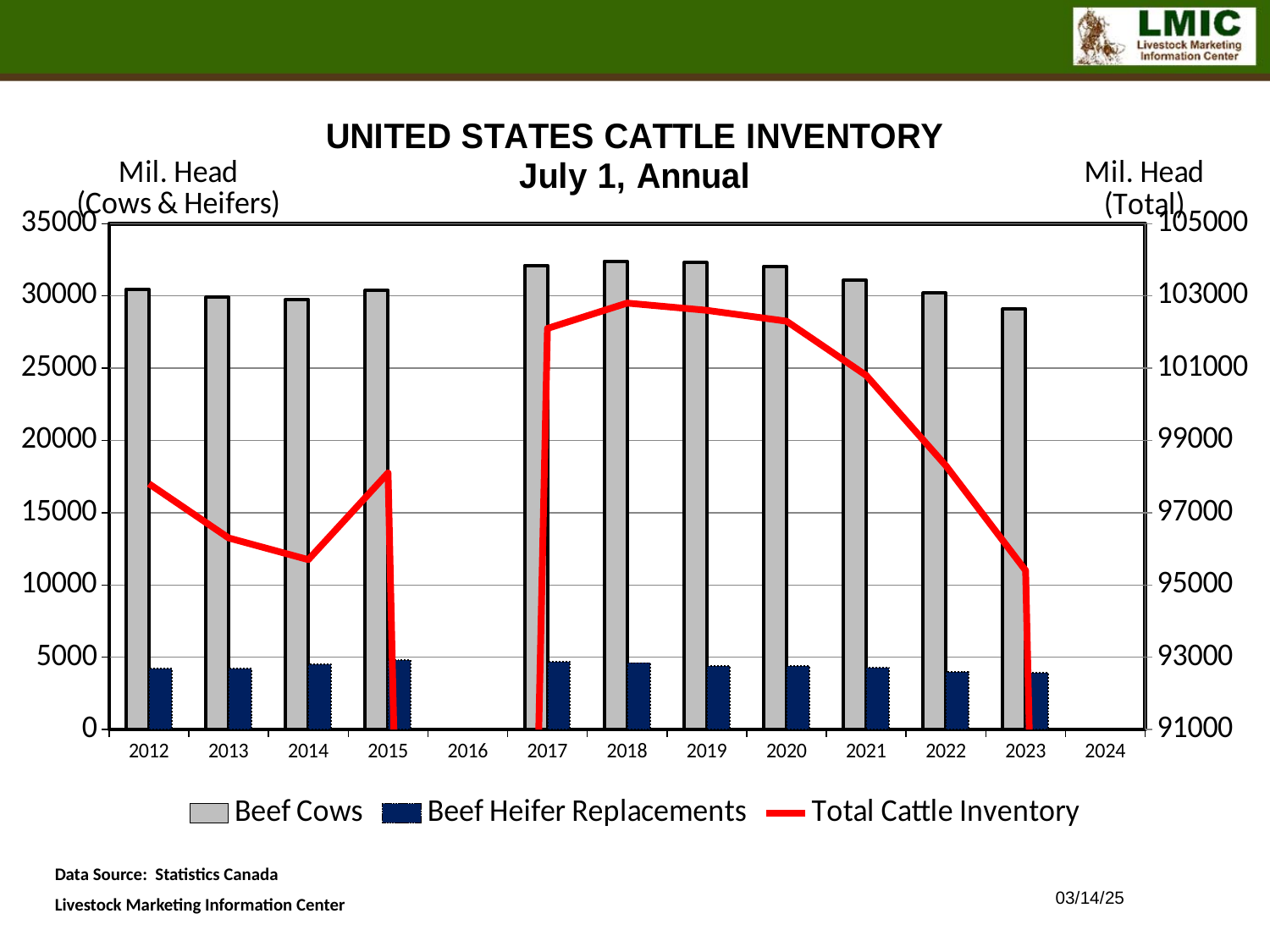
Does the Total Cattle Inventory line rise or fall from 2018 to 2023? fall How many years on the x axis have bars plotted? 11 Is the Beef Cows value for 2023 greater or less than 30000? less What is the title of the chart? UNITED STATES CATTLE INVENTORY July 1, Annual Is the Beef Cows value for 2018 greater or less than 30000? greater What kind of chart is shown on the slide? A combined bar and line chart Which year has the larger Total Cattle Inventory, 2020 or 2022? 2020 How many series does the legend list? 3 Is the Total Cattle Inventory value for 2023 greater or less than 97000? less In which year is the Total Cattle Inventory line at its highest? 2018 What are the three series listed in the legend? Beef Cows, Beef Heifer Replacements, Total Cattle Inventory In which year is the Beef Cows bar the lowest? 2023